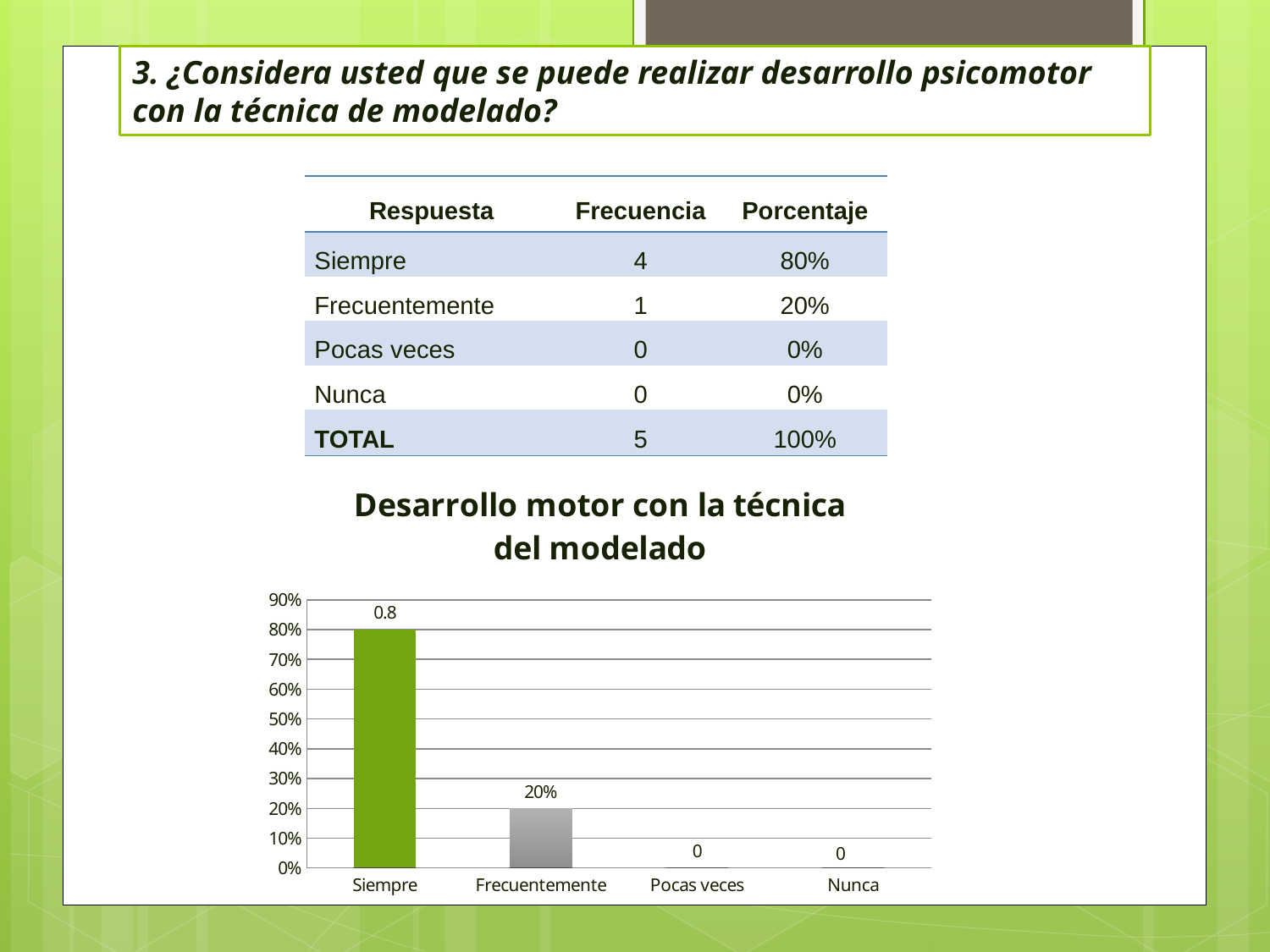
Is the value for Siempre greater or less than 50%? greater Which category has the highest bar in the chart? Siempre Is the value for Frecuentemente greater or less than 30%? less What is the data label shown for Nunca? 0 What type of chart is shown on the slide? bar chart What is the data label shown on the bar for Siempre? 0.8 What is the title of the chart? Desarrollo motor con la técnica del modelado How many categories are shown on the x axis of the chart? 4 What is the data label shown on the bar for Frecuentemente? 20% What is the data label shown for Pocas veces? 0 What is the highest value shown on the y axis of the chart? 90% Which bar is taller, Siempre or Frecuentemente? Siempre